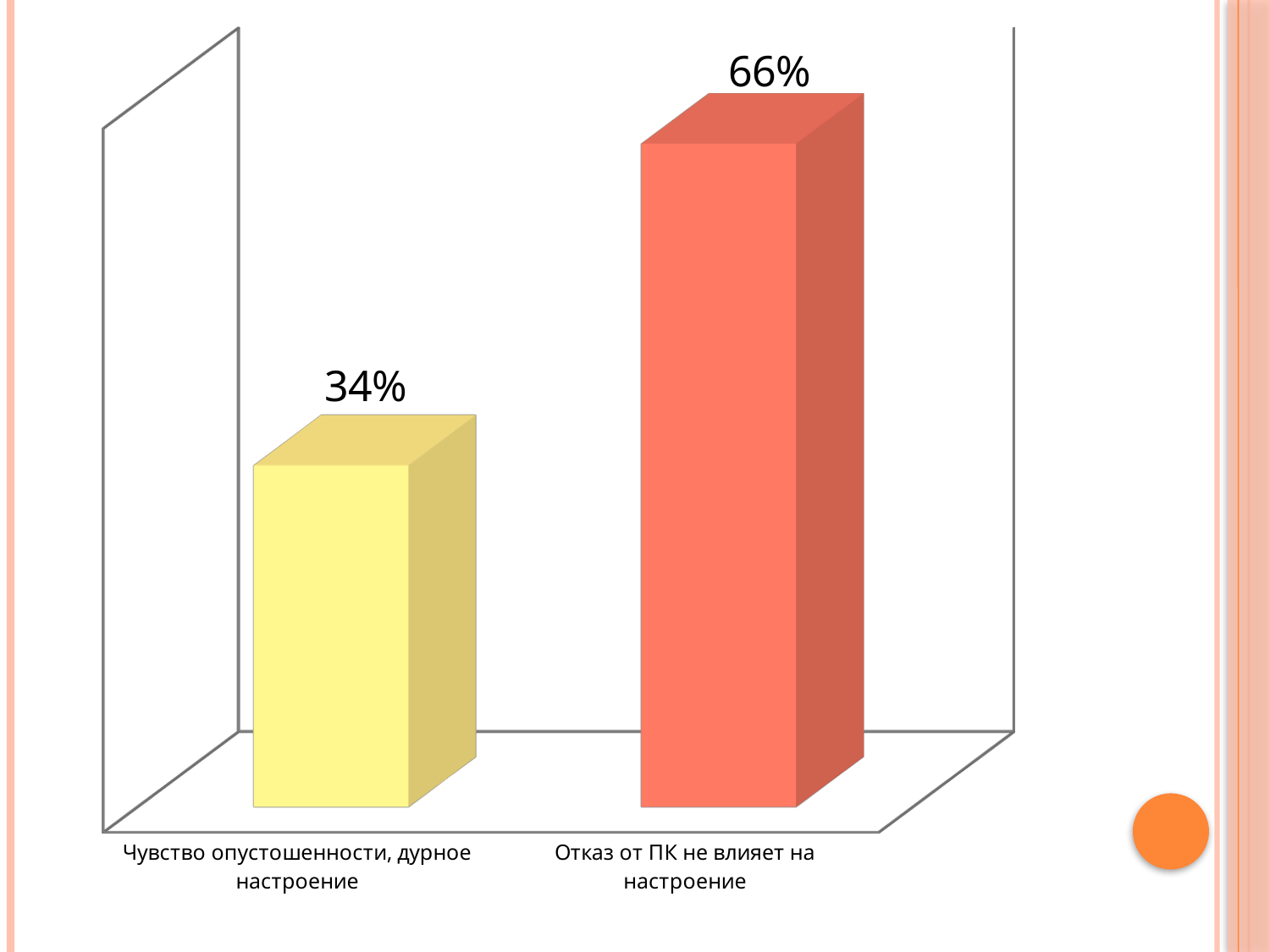
What colour is the bar for "Отказ от ПК не влияет на настроение"? Red Which category has the highest value? Отказ от ПК не влияет на настроение How many categories are shown in the chart? 2 What is the value for "Отказ от ПК не влияет на настроение"? 66% Which category has the lowest value? Чувство опустошенности, дурное настроение What colour is the bar for "Чувство опустошенности, дурное настроение"? Yellow What is the total of the two values shown in the chart? 100% What is the value for "Чувство опустошенности, дурное настроение"? 34% Which is larger: the value for "Чувство опустошенности, дурное настроение" or the value for "Отказ от ПК не влияет на настроение"? Отказ от ПК не влияет на настроение What is the difference between the values for "Отказ от ПК не влияет на настроение" and "Чувство опустошенности, дурное настроение"? 32% What kind of chart is shown on the slide? Bar chart